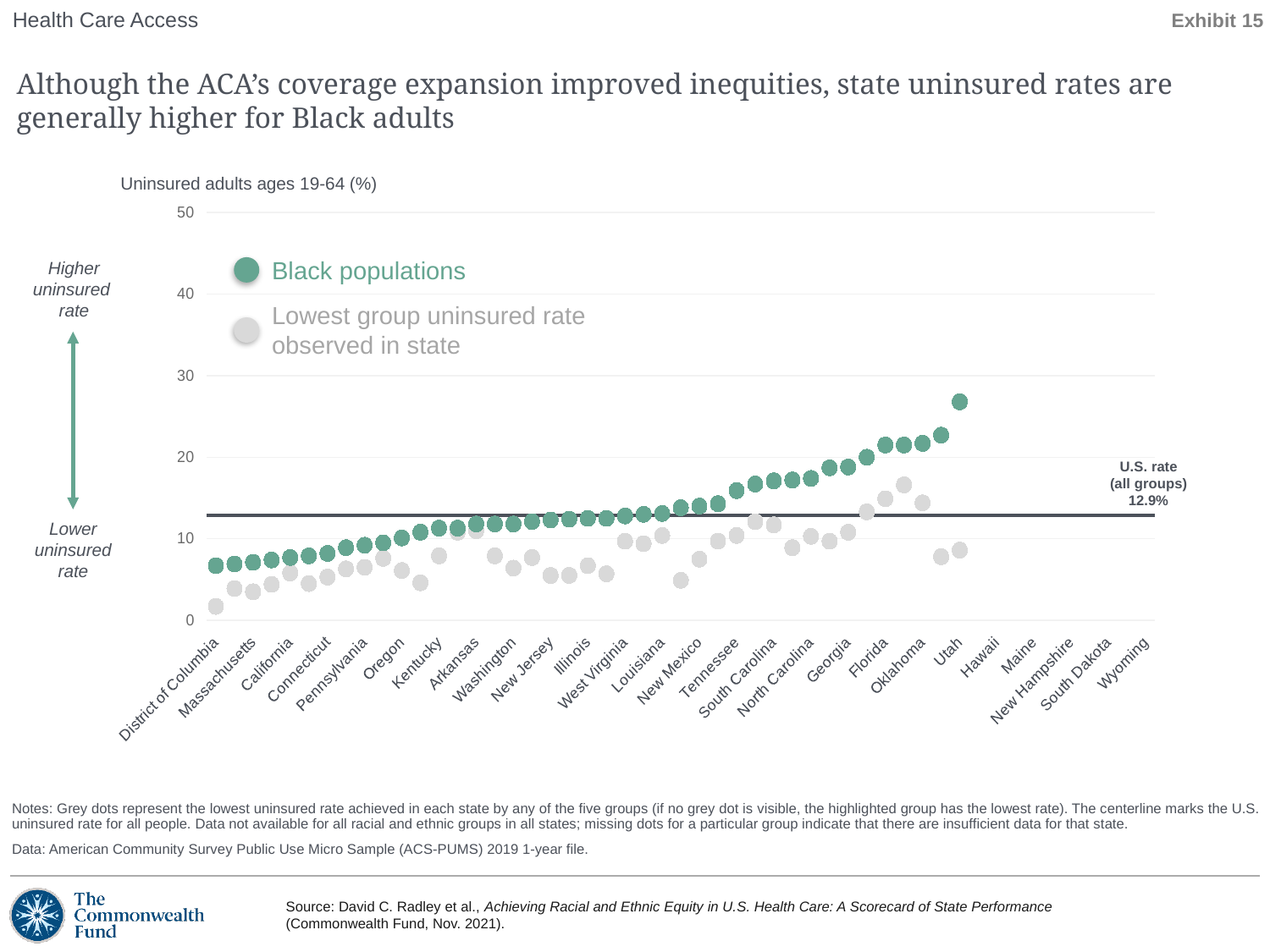
Is the uninsured rate for Black populations in Utah greater or less than 20? greater What kind of chart is shown on the slide? Dot (scatter) chart How many series does the legend list? 2 Is the uninsured rate for Black populations in Tennessee greater or less than 10? greater Do the uninsured rates for Black populations rise or fall moving from left to right across the states? rise Which state has the highest uninsured rate for Black populations? Utah What does the grey dot in the legend represent? Lowest group uninsured rate observed in state Which state has the lowest uninsured rate for Black populations? District of Columbia Is the lowest group uninsured rate observed in Massachusetts (grey dot) greater or less than 10? less What is the U.S. uninsured rate for all groups marked by the centerline? 12.9% Which is larger: the uninsured rate for Black populations in Utah or in District of Columbia? Utah